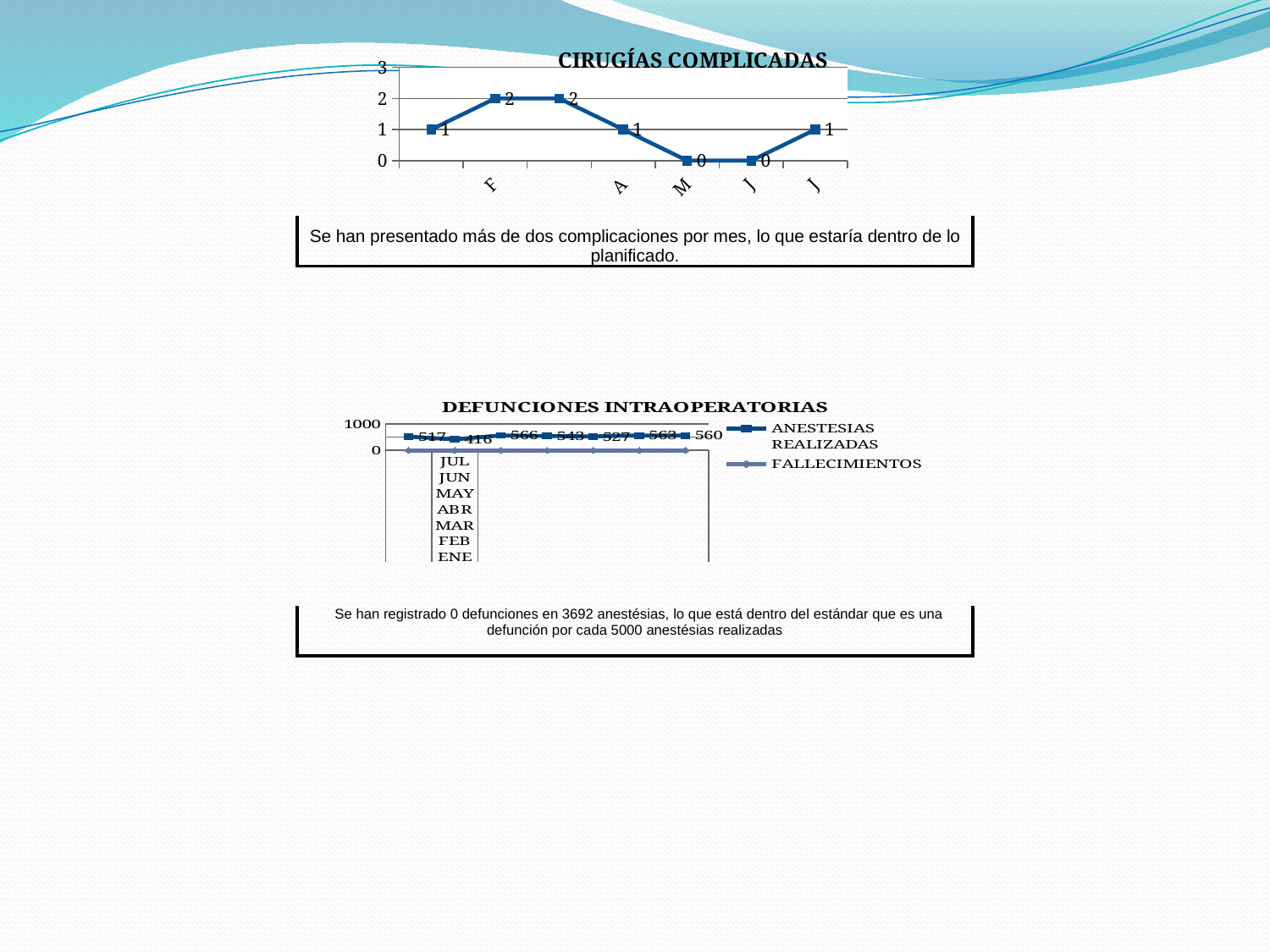
In the CIRUGÍAS COMPLICADAS chart, what is the highest value plotted? 2 In the DEFUNCIONES INTRAOPERATORIAS chart, how many series does the legend list? 2 In the DEFUNCIONES INTRAOPERATORIAS chart, what is the lowest data label shown for ANESTESIAS REALIZADAS? 416 In the CIRUGÍAS COMPLICADAS chart, what is the value for the month labelled M? 0 In the CIRUGÍAS COMPLICADAS chart, what type of chart is shown? Line chart In the CIRUGÍAS COMPLICADAS chart, what is the value for the month labelled F? 2 In the CIRUGÍAS COMPLICADAS chart, how many data points are plotted? 7 In the CIRUGÍAS COMPLICADAS chart, is the value for F larger or smaller than the value for M? Larger In the DEFUNCIONES INTRAOPERATORIAS chart, what is the highest data label shown for ANESTESIAS REALIZADAS? 566 In the DEFUNCIONES INTRAOPERATORIAS chart, what are the two series named in the legend? ANESTESIAS REALIZADAS and FALLECIMIENTOS In the CIRUGÍAS COMPLICADAS chart, what is the difference between the value for F and the value for A? 1 In the CIRUGÍAS COMPLICADAS chart, what is the value for the month labelled A? 1